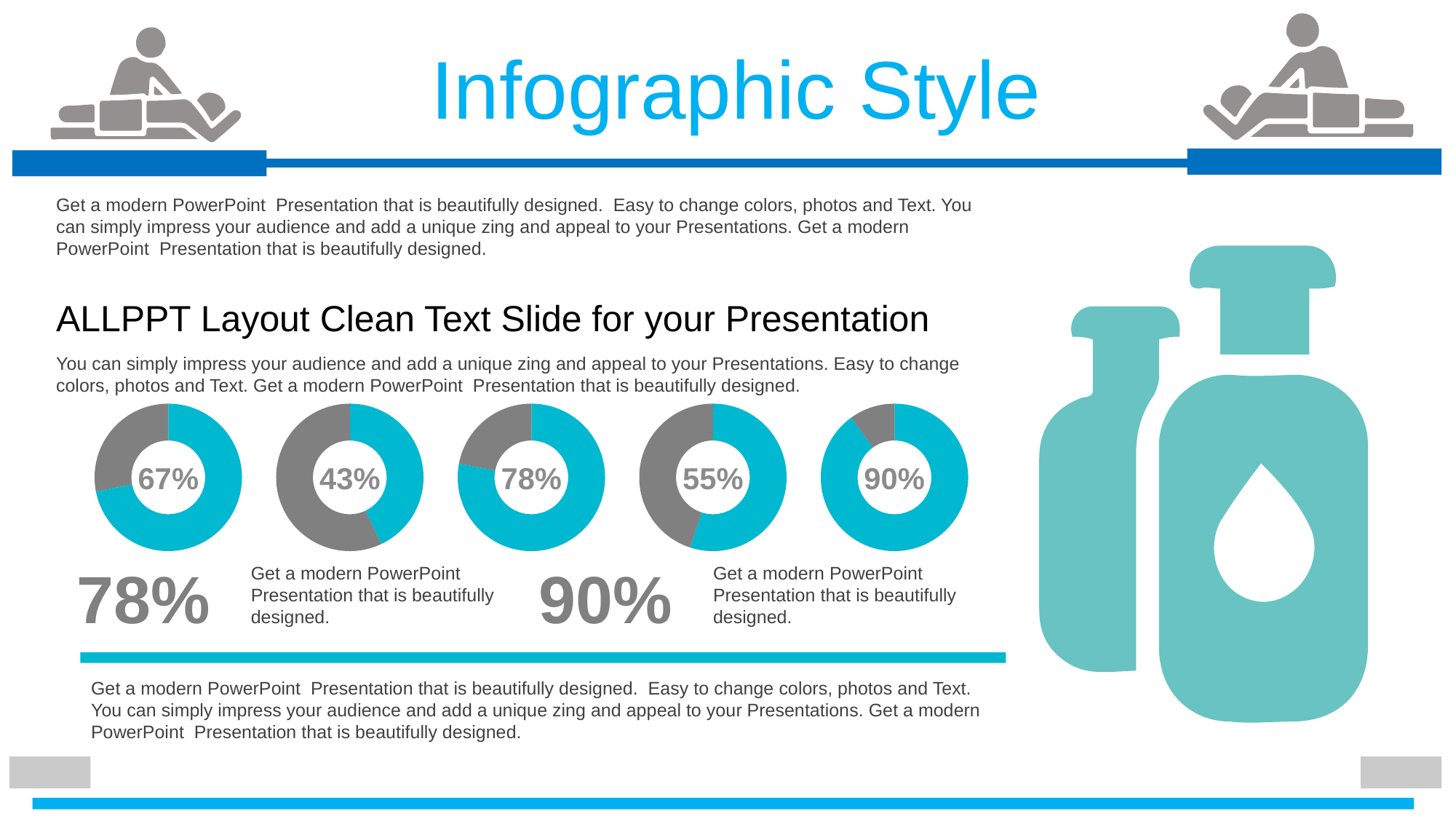
Which donut chart shows the highest percentage? The rightmost one (90%) What value is shown in the center of the second donut chart from the left? 43% What two colours are used for the segments of the donut charts? Cyan and gray What value is shown in the center of the rightmost donut chart? 90% Which donut chart shows the lowest percentage? The second from the left (43%) What value is shown in the center of the middle (third) donut chart? 78% What is the difference between the value in the rightmost donut chart and the value in the leftmost donut chart? 23% What value is shown in the center of the fourth donut chart from the left? 55% What kind of chart is used to display the percentages on the slide? Donut chart Which is larger: the value in the third donut chart or the value in the fourth donut chart? The third donut chart (78%) How many donut charts are shown on the slide? 5 What value is shown in the center of the leftmost donut chart? 67%